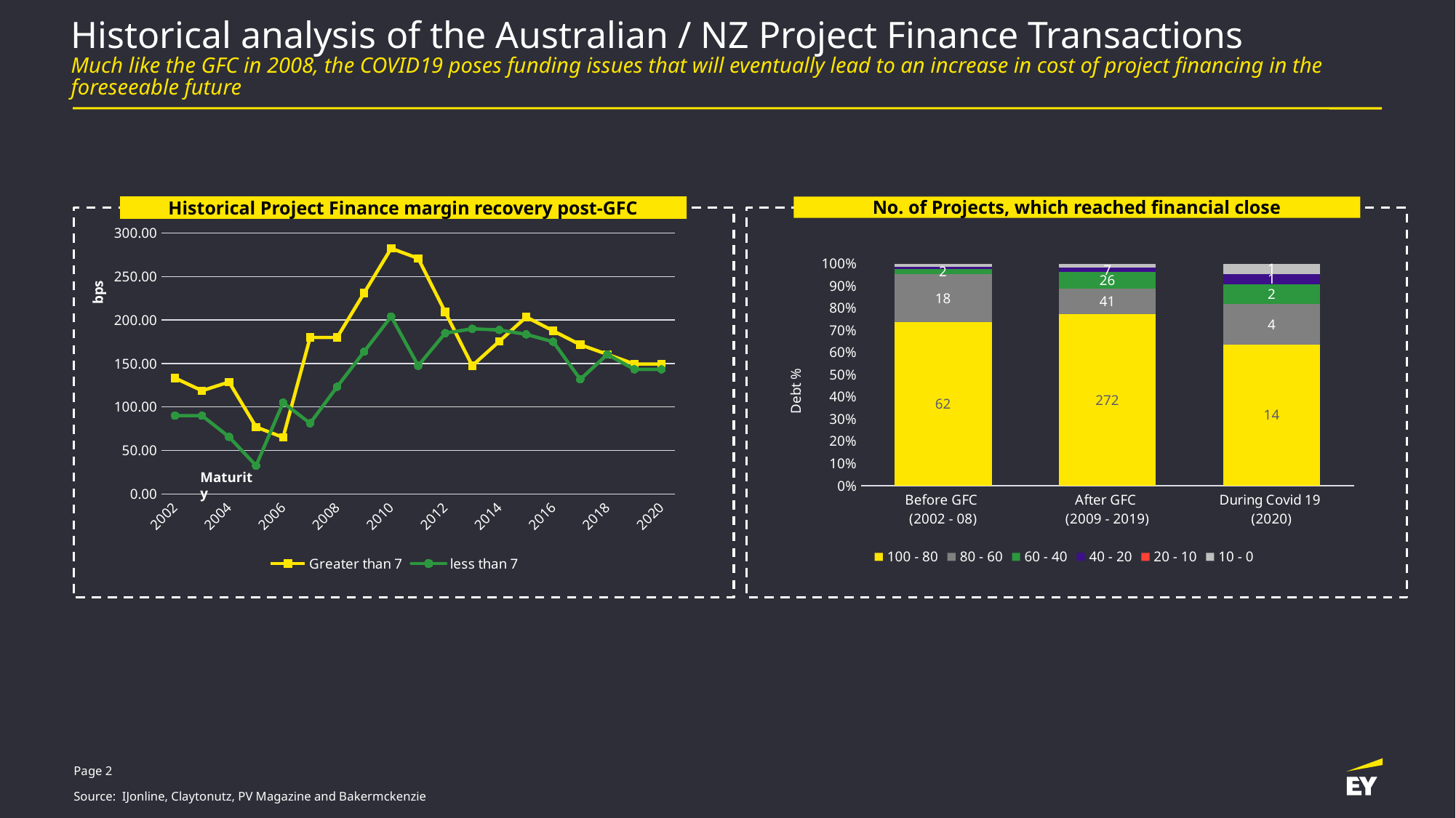
In the 'No. of Projects, which reached financial close' chart, which period has the highest number of projects in the 100 - 80 band? After GFC (2009 - 2019) In the 'Historical Project Finance margin recovery post-GFC' chart, is the value for 'less than 7' in 2005 greater or less than 50.00? less In the 'Historical Project Finance margin recovery post-GFC' chart, in which year does the 'Greater than 7' series reach its highest value? 2010 In the 'Historical Project Finance margin recovery post-GFC' chart, which series has the larger value in 2010, 'Greater than 7' or 'less than 7'? Greater than 7 How many periods (categories) are shown on the x axis of the 'No. of Projects, which reached financial close' chart? 3 In the 'Historical Project Finance margin recovery post-GFC' chart, is the value for 'Greater than 7' in 2010 greater or less than 250.00? greater How many series does the legend of the 'Historical Project Finance margin recovery post-GFC' chart list? 2 In the 'No. of Projects, which reached financial close' chart, how many projects are in the 80 - 60 band for Before GFC (2002 - 08)? 18 How many series does the legend of the 'No. of Projects, which reached financial close' chart list? 6 In the 'No. of Projects, which reached financial close' chart, how many projects are in the 100 - 80 band for After GFC (2009 - 2019)? 272 What kind of chart is the 'Historical Project Finance margin recovery post-GFC' chart? line chart In the 'No. of Projects, which reached financial close' chart, what is the difference between the 100 - 80 band values for After GFC (2009 - 2019) and Before GFC (2002 - 08)? 210